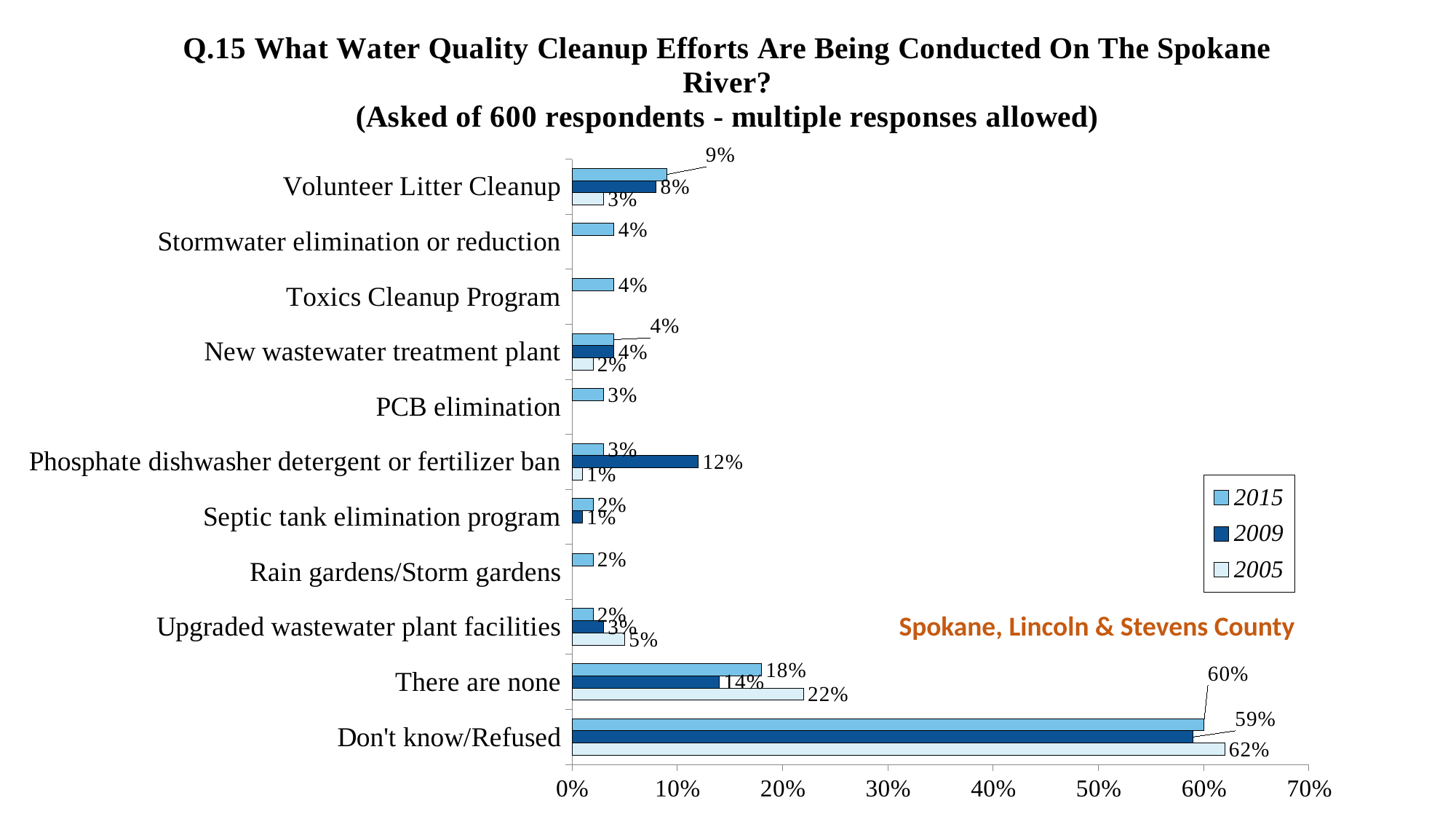
What is the difference between the 2005 and 2009 values for Don't know/Refused? 3% How many series does the legend list? 3 Which year's legend entry is shown with the darkest blue colour? 2009 Which is larger for There are none: the 2015 value or the 2009 value? 2015 How many categories are shown on the vertical axis? 11 What is the difference between the 2015 and 2005 values for Volunteer Litter Cleanup? 6% What is the 2015 value for Volunteer Litter Cleanup? 9% Is the 2005 value for Don't know/Refused greater or less than 60%? greater Which category has the highest 2015 value? Don't know/Refused What is the 2009 value for Phosphate dishwasher detergent or fertilizer ban? 12% What is the 2005 value for There are none? 22% What kind of chart is shown on the slide? bar chart